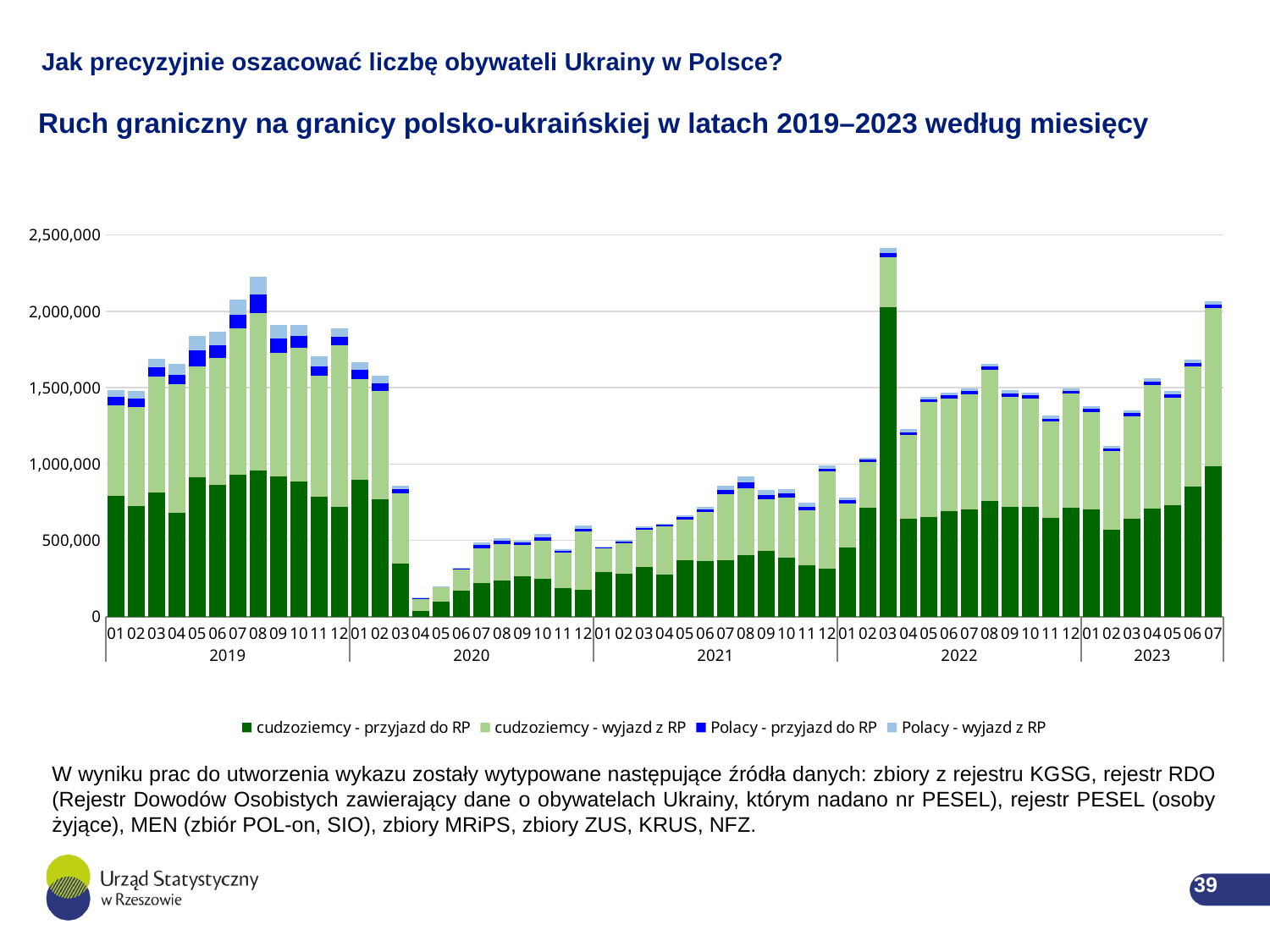
Which month has the shortest bar in the chart? 04 2020 Which bar is taller: 03 2022 or 08 2019? 03 2022 Do the bar totals rise or fall from 04 2020 to 12 2020? rise Which month has the tallest bar in the chart? 03 2022 Is the total value for 01 2021 greater or less than 1,000,000? less What kind of chart is shown on the slide? stacked bar chart Is the total value for 03 2022 greater or less than 2,000,000? greater How many series does the legend list? 4 Is the total value for 04 2020 greater or less than 500,000? less How many months are shown for 2023? 7 Which bar is taller: 04 2019 or 04 2020? 04 2019 How many years are labelled on the x axis? 5